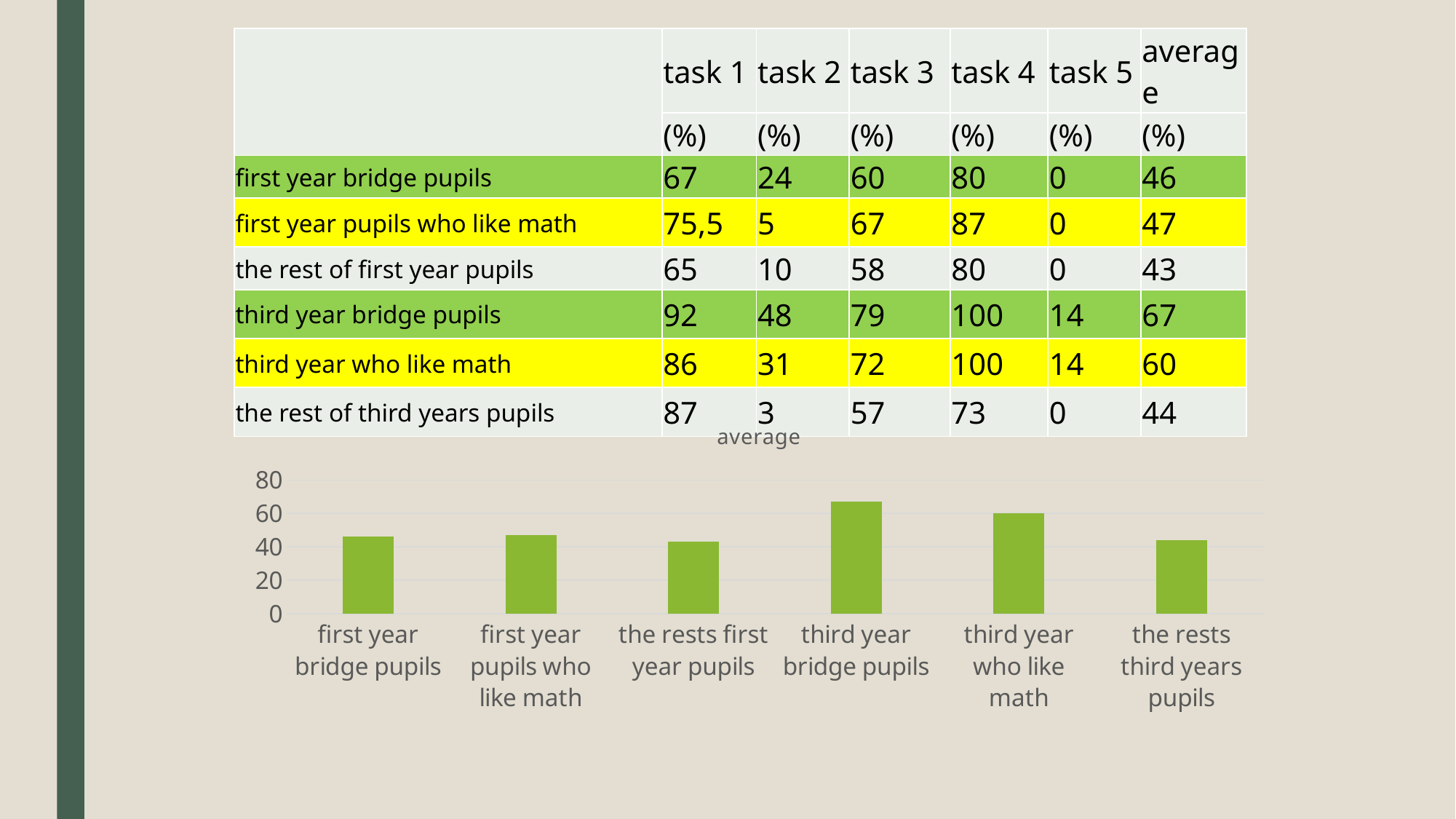
Is the value for first year pupils who like math greater or less than 40? greater Which is larger, the bar for third year bridge pupils or the bar for first year bridge pupils? third year bridge pupils Is the value for first year bridge pupils greater or less than 60? less What is the title of the chart? average What kind of chart is shown on the slide? bar chart What colour are the bars in the chart? green Which category has the highest bar in the chart? third year bridge pupils How many categories are shown on the x axis of the chart? 6 Is the value for the rests third years pupils greater or less than 60? less According to the table, what is the average (%) for third year bridge pupils, the value plotted in the chart? 67 Which is larger, the bar for third year who like math or the bar for the rests third years pupils? third year who like math